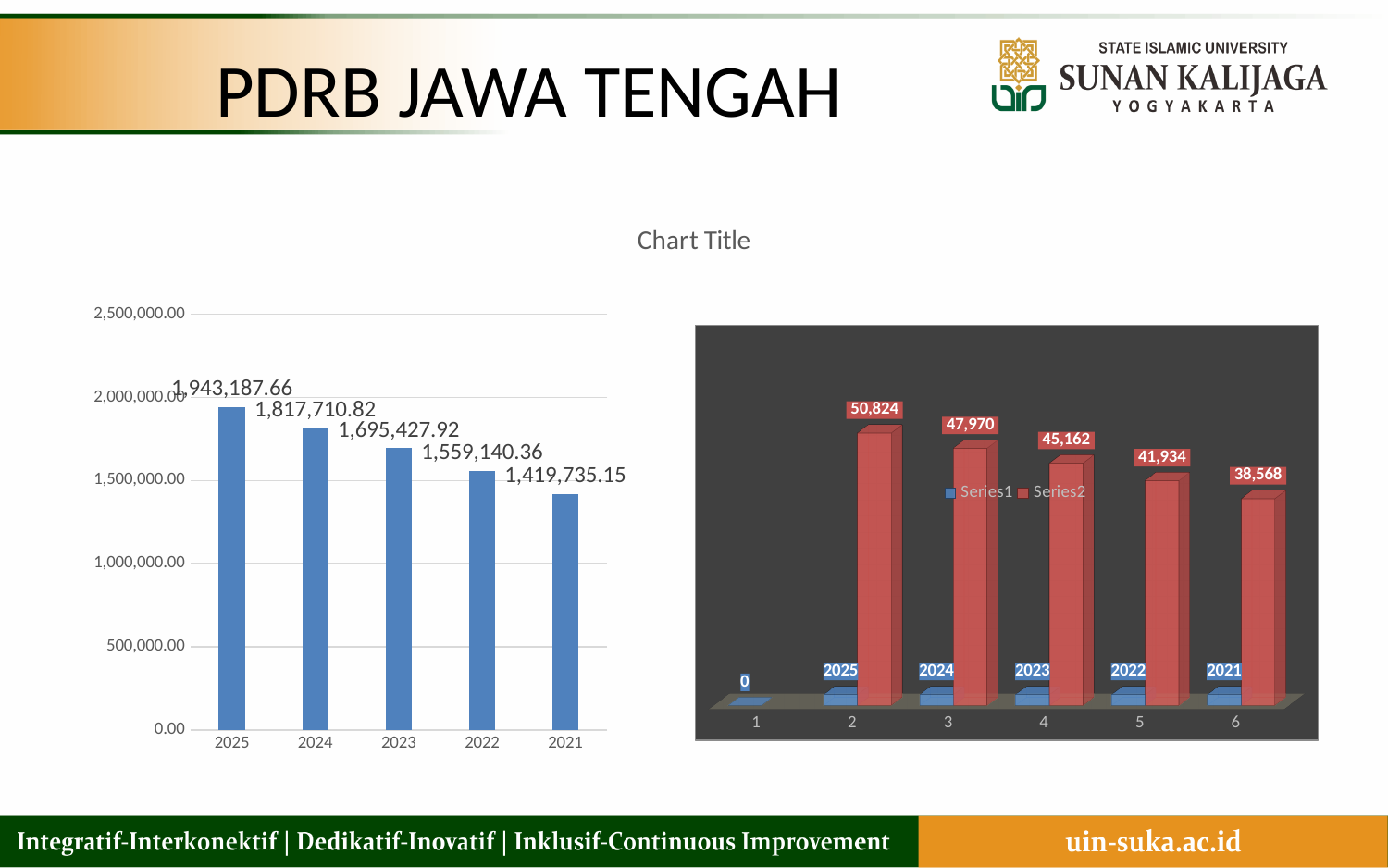
On the left chart, what is the difference between the values for 2025 and 2024? 125,476.84 On the left chart, how many bars are plotted? 5 On the left chart, is the value for 2023 greater or less than 1,500,000.00? greater On the left chart, do the values rise or fall moving from left to right along the x axis? fall On the left chart, which year has the lowest value? 2021 On the right chart, what is the Series2 value at category 6? 38,568 On the right chart, what is the Series2 value at category 2? 50,824 On the right chart, which category has the highest Series2 value? 2 On the right chart, what is the difference between the Series2 values at categories 3 and 4? 2,808 On the left chart, what is the value for 2021? 1,419,735.15 On the left chart, what is the value for 2025? 1,943,187.66 On the right chart, how many series does the legend list? 2